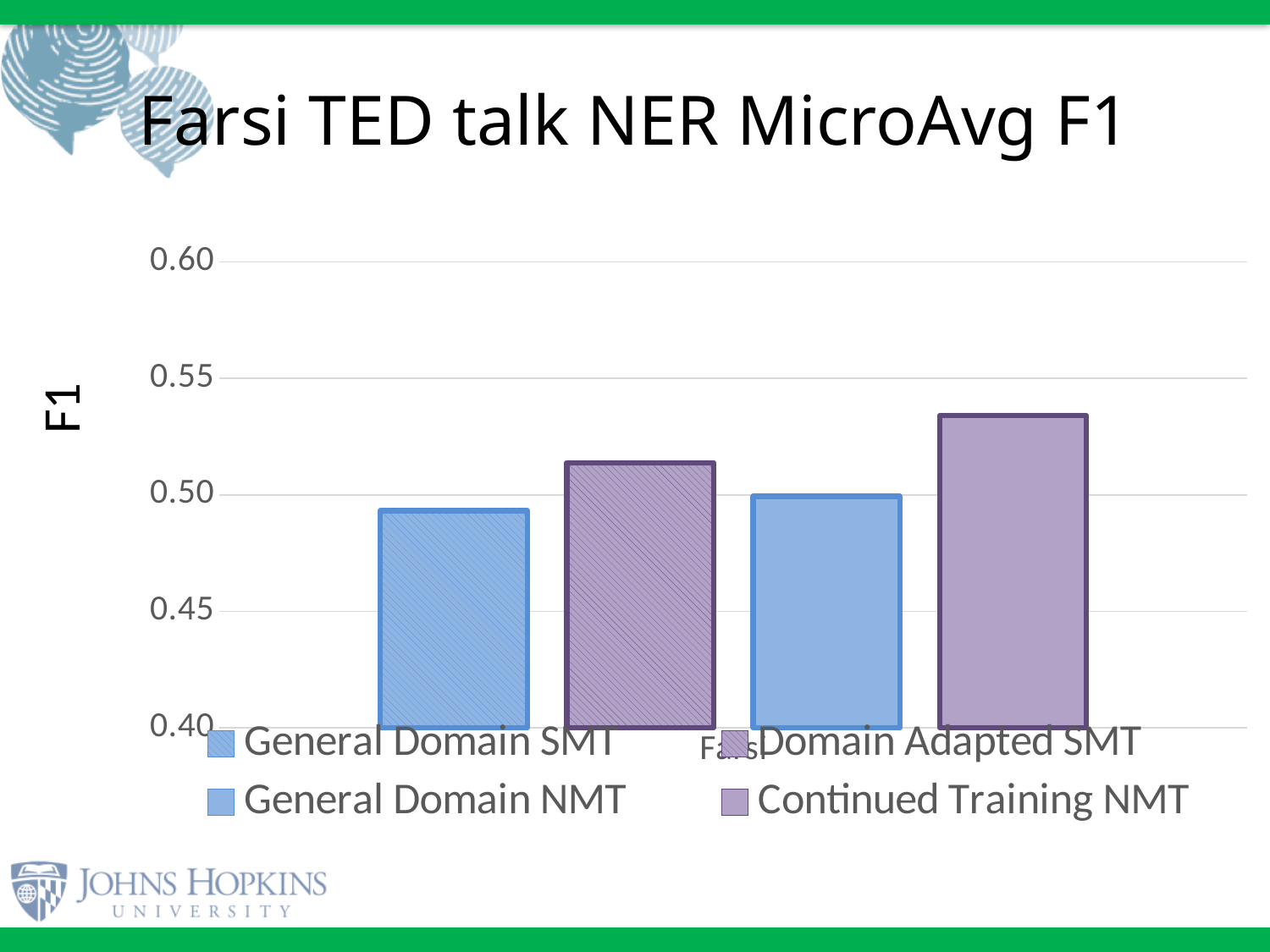
What is the label of the y axis? F1 Which is larger, the value for Domain Adapted SMT or the value for General Domain NMT? Domain Adapted SMT Is the value for Domain Adapted SMT greater or less than 0.50? greater Which series has the highest F1 value? Continued Training NMT How many categories are shown on the x axis? 1 Which is larger, the value for Continued Training NMT or the value for Domain Adapted SMT? Continued Training NMT Is the value for Continued Training NMT greater or less than 0.55? less How many series does the legend list? 4 Is the value for General Domain SMT greater or less than 0.50? less What is the title of the chart? Farsi TED talk NER MicroAvg F1 What kind of chart is shown on the slide? bar chart